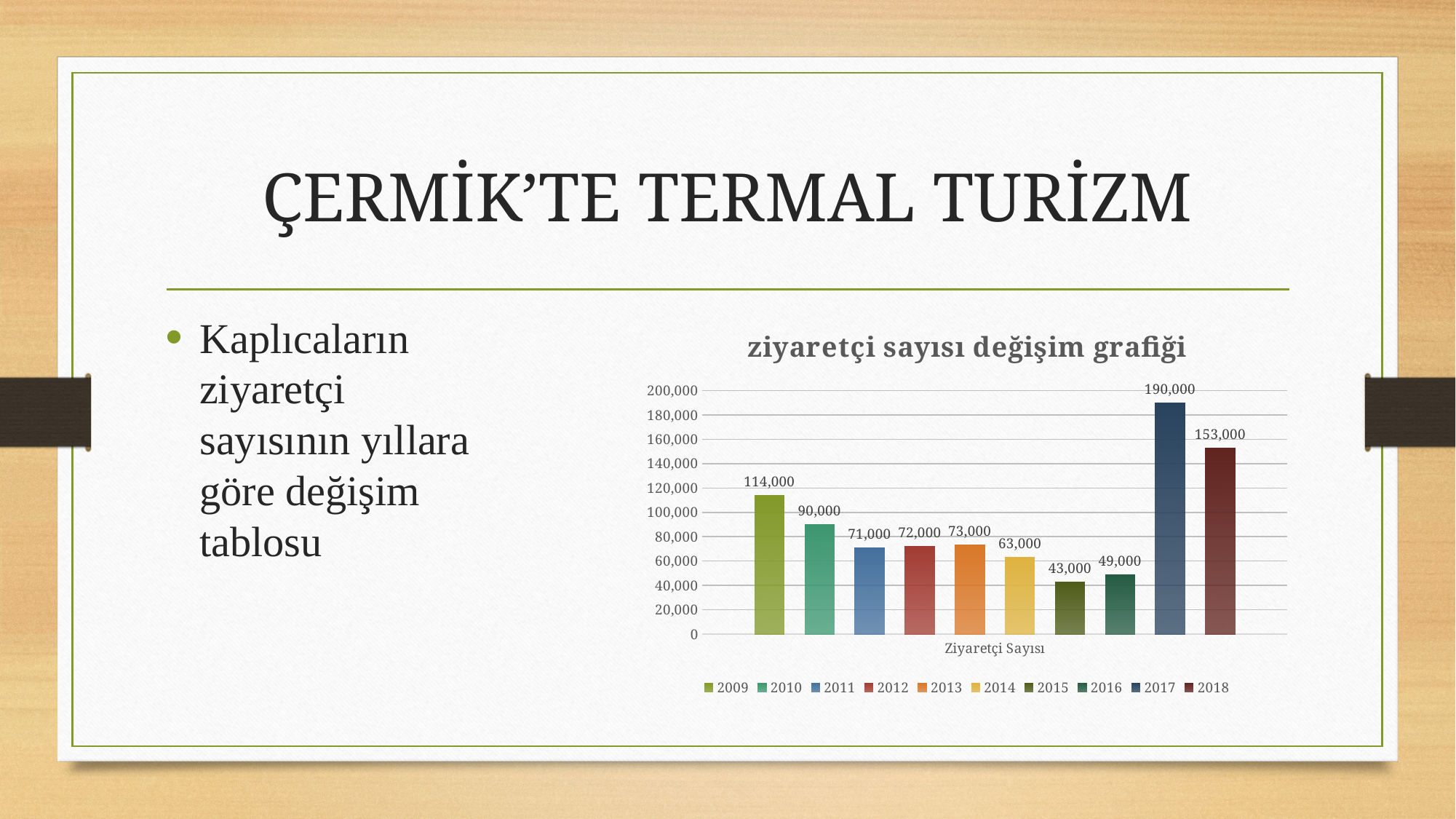
What is the value for 2015 in the chart? 43,000 Is the value for 2016 greater or less than 60,000? less What is the value for 2017 in the chart? 190,000 How many series does the legend list? 10 What is the value for 2009 in the chart? 114,000 What is the difference between the values for 2009 and 2010? 24,000 Which is larger, the value for 2013 or the value for 2014? 2013 Which year has the lowest visitor count? 2015 Which year has the highest visitor count? 2017 What kind of chart is shown on the slide? bar chart What is the difference between the values for 2017 and 2018? 37,000 What is the title of the chart? ziyaretçi sayısı değişim grafiği